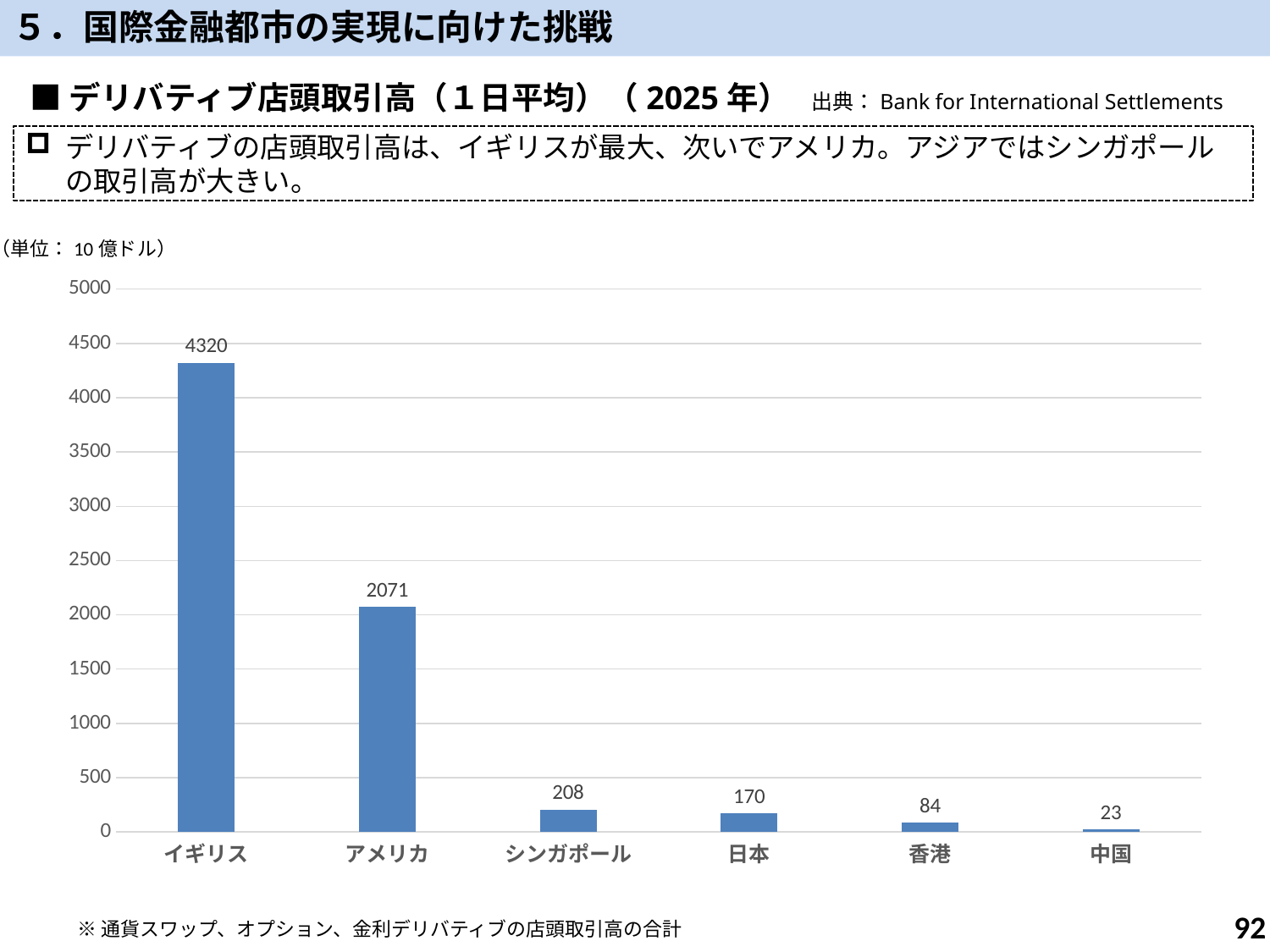
Which is larger, the value for シンガポール or the value for 日本? シンガポール What kind of chart is shown on the slide? bar chart How many categories are shown on the x axis? 6 What unit is stated for the chart values? 10億ドル Is the value for アメリカ greater or less than 2500? less What is the difference between the values for 日本 and 香港? 86 What is the value for 香港 (Hong Kong)? 84 What is the value for シンガポール (Singapore)? 208 Which category has the highest value? イギリス Which category has the lowest value? 中国 What is the difference between the values for イギリス and アメリカ? 2249 What is the value for イギリス (UK)? 4320